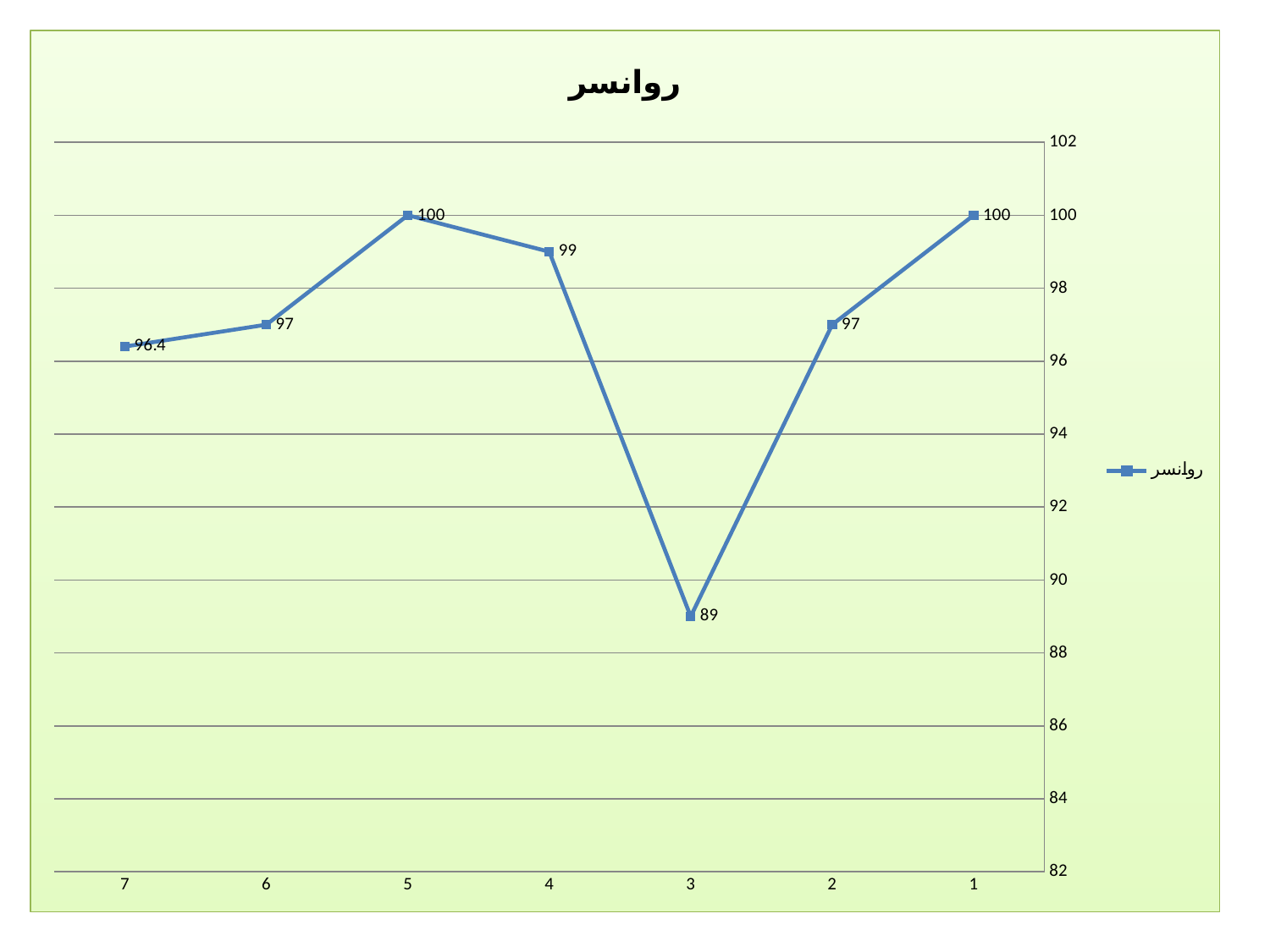
What is the value for category 3? 89 How many data points are plotted on the line? 7 What is the difference between the values for category 5 and category 3? 11 What is the difference between the values for category 4 and category 7? 2.6 What is the value for category 4? 99 What is the value for category 2? 97 Is the value for category 3 greater or less than 90? less How many series does the legend list? 1 What is the value for category 7? 96.4 Which is larger, the value for category 4 or the value for category 6? category 4 What type of chart is shown on the slide? line chart Which category has the lowest value? 3